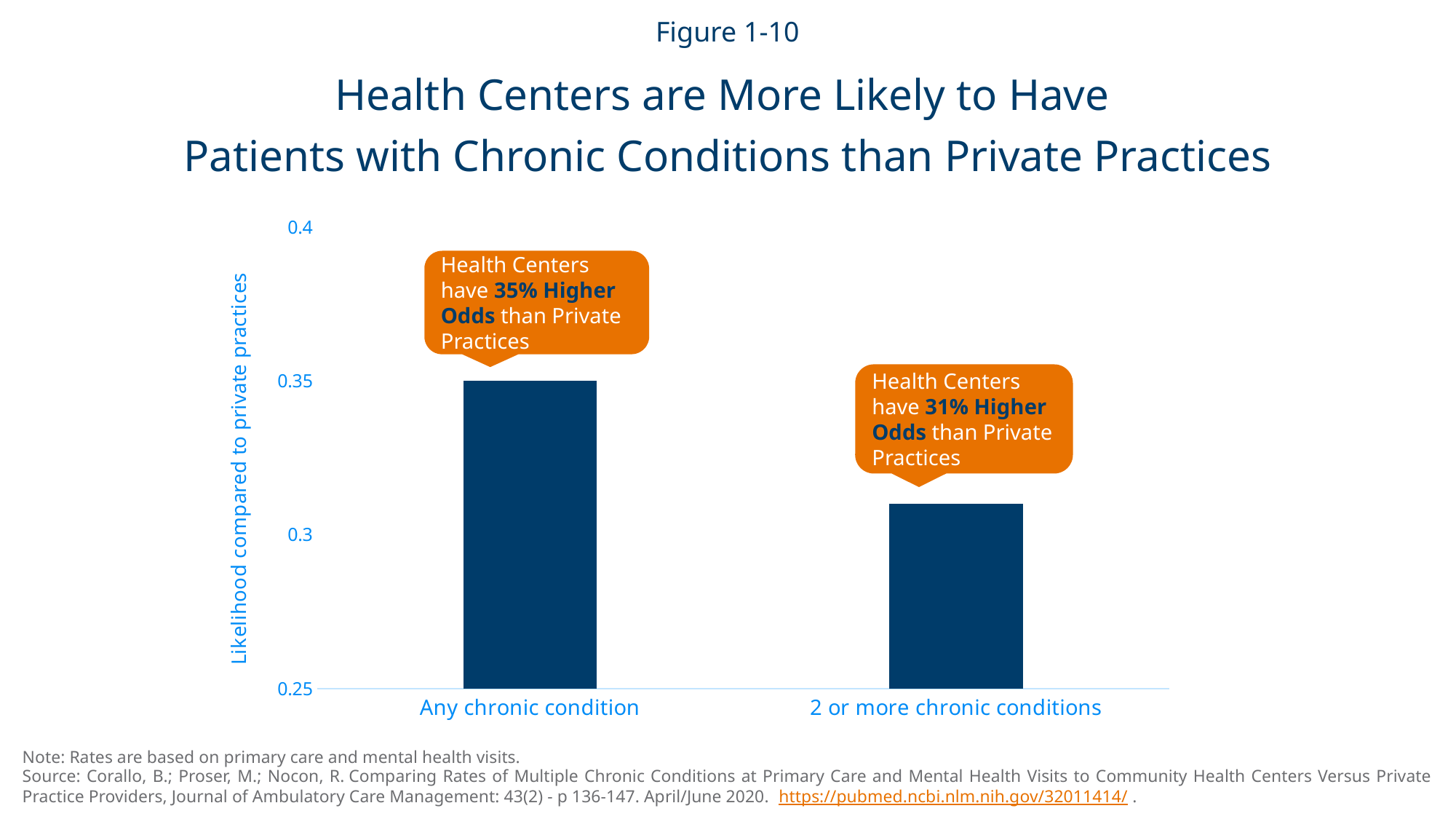
What is the figure number shown above the chart title? Figure 1-10 Is the value for 2 or more chronic conditions greater or less than 0.35? less What is the label of the y axis? Likelihood compared to private practices Which is larger, the bar for Any chronic condition or the bar for 2 or more chronic conditions? Any chronic condition How many categories are plotted on the x axis? 2 What kind of chart is shown on the slide? bar chart Which category has the lowest bar? 2 or more chronic conditions What is the value of the bar for Any chronic condition? 0.35 Is the value for 2 or more chronic conditions greater or less than 0.3? greater According to the callout, how much higher odds do Health Centers have than Private Practices for Any chronic condition? 35% Higher Odds Which category has the highest bar? Any chronic condition According to the callout, how much higher odds do Health Centers have than Private Practices for 2 or more chronic conditions? 31% Higher Odds